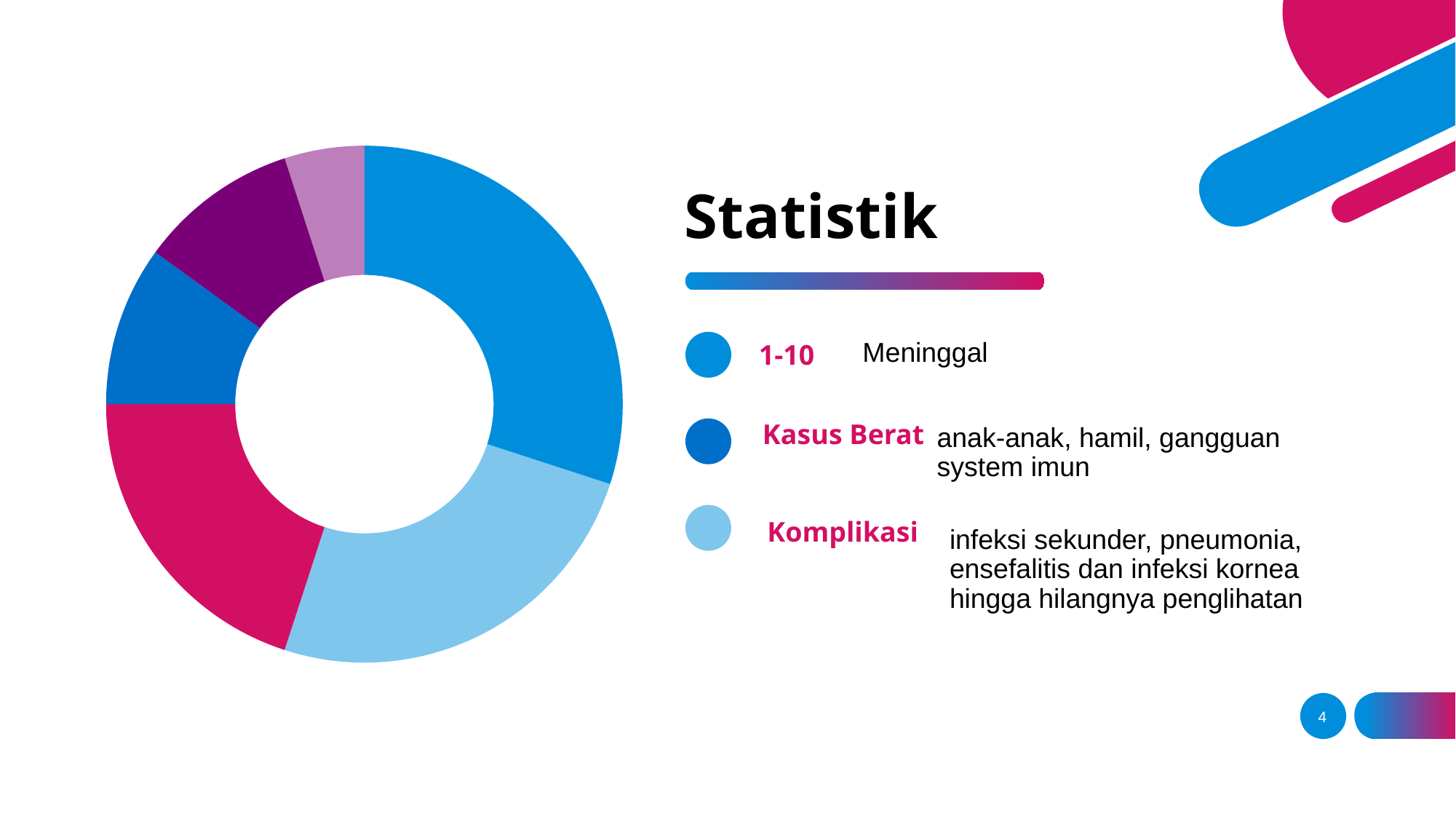
Which slice is larger: the magenta slice or the dark blue slice? The magenta slice Which slice is larger: the light blue slice or the dark blue slice? The light blue slice How many slices does the donut chart have? 6 Which slice of the donut chart is the smallest? The light purple (mauve) slice at the top What kind of chart is shown on the slide? Pie (donut) chart Which slice is larger: the dark purple slice or the light purple (mauve) slice? The dark purple slice What is the title shown next to the chart? Statistik Which slice of the donut chart is the largest? The medium blue slice (top right) What colour is the marker next to the label "Kasus Berat"? Dark blue